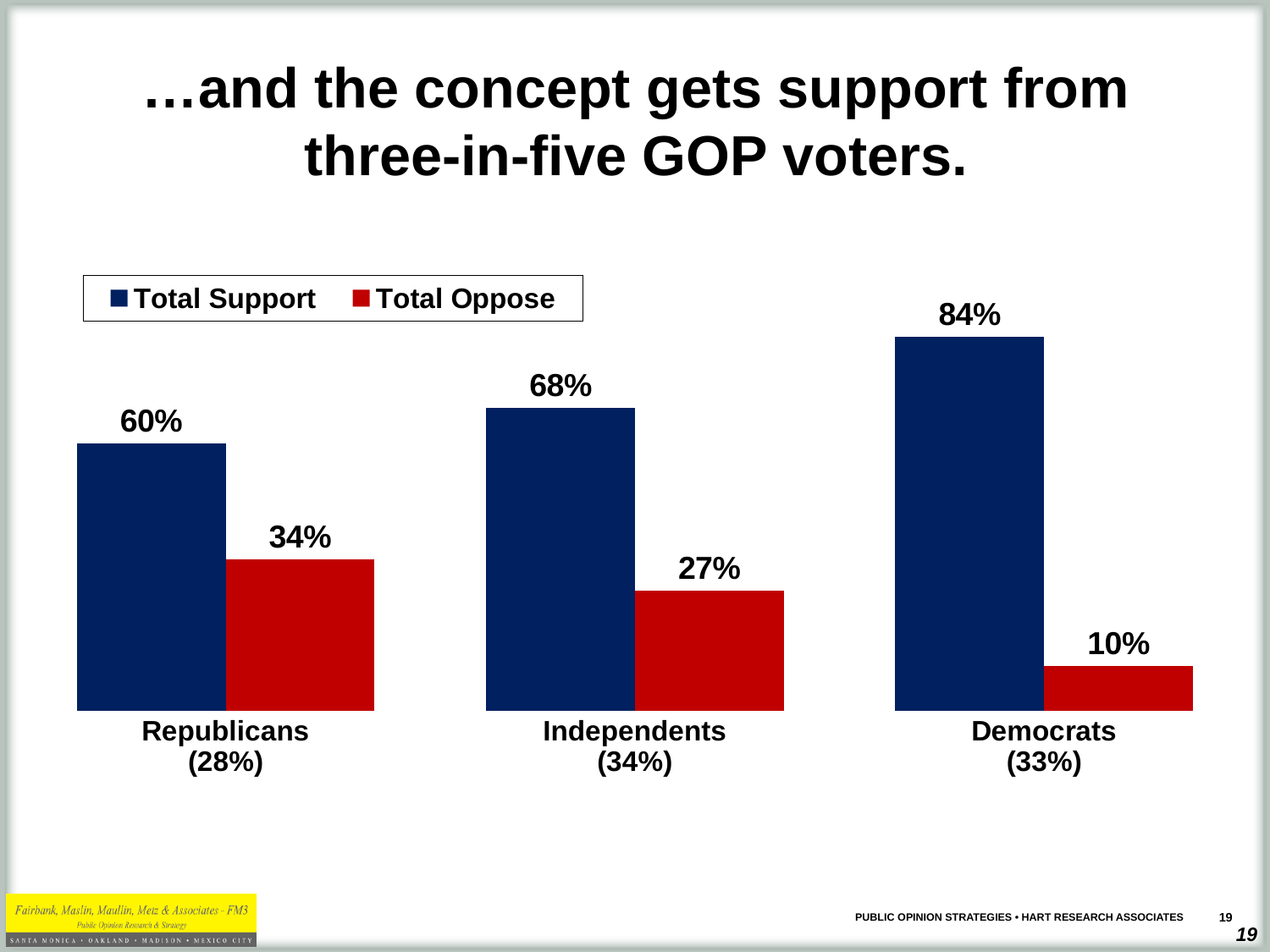
How many series does the legend list? 2 Which is larger, the Total Oppose value for Republicans or for Independents? Republicans What is the difference between the Total Support values for Democrats and Republicans? 24% What is the Total Support value for Republicans? 60% What is the Total Support value for Independents? 68% What is the difference between Total Support and Total Oppose for Independents? 41% Which group has the highest Total Support value? Democrats Which group has the lowest Total Oppose value? Democrats What is the Total Oppose value for Republicans? 34% What kind of chart is shown on the slide? Bar chart What is the Total Oppose value for Democrats? 10% How many groups are shown on the x axis? 3